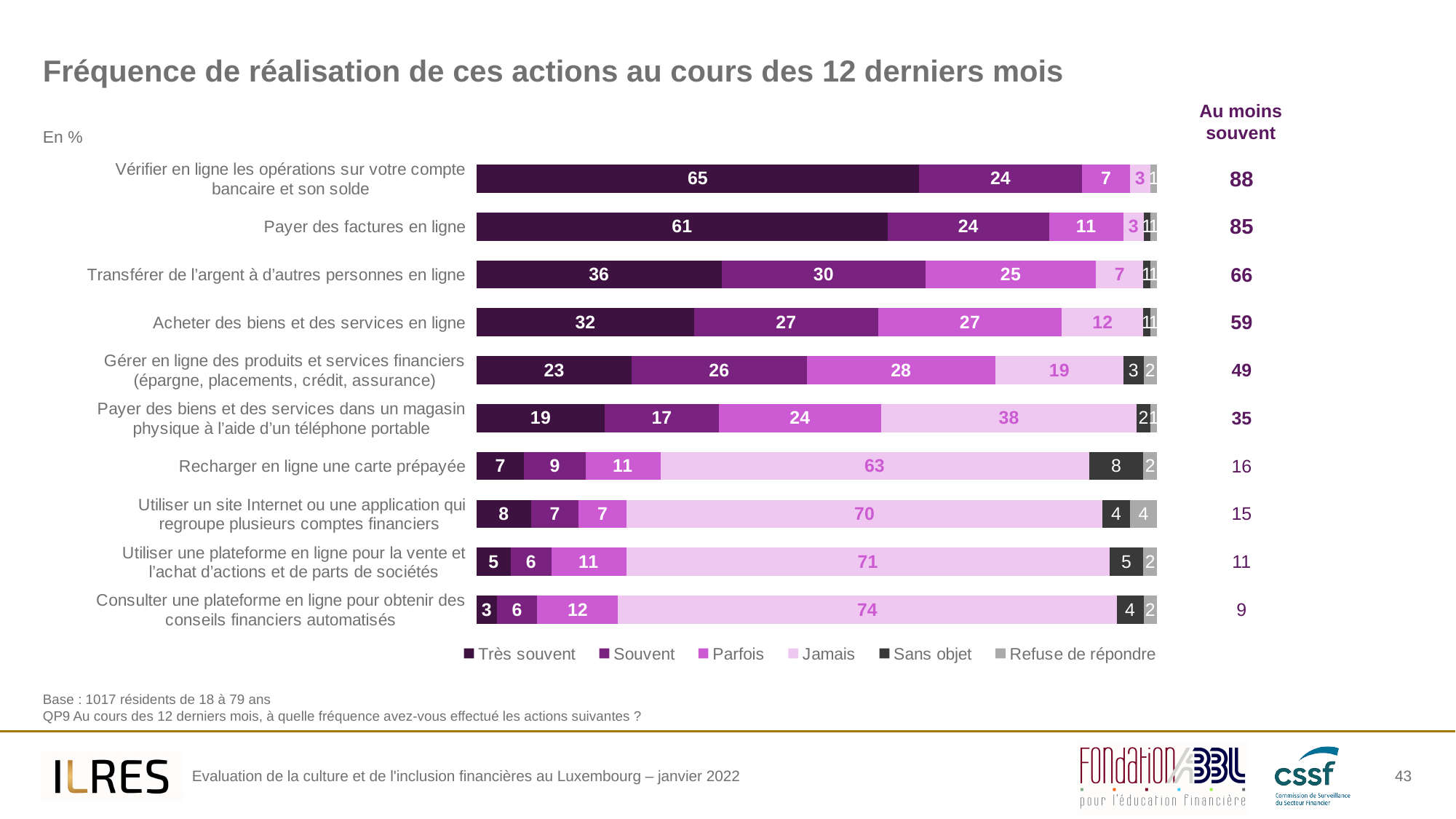
What is the "Parfois" value for "Transférer de l'argent à d'autres personnes en ligne"? 25 What is the "Jamais" value for "Recharger en ligne une carte prépayée"? 63 What kind of chart is shown on the slide? Stacked bar chart Which has a larger "Souvent" value: "Transférer de l'argent à d'autres personnes en ligne" or "Gérer en ligne des produits et services financiers"? Transférer de l'argent à d'autres personnes en ligne What is the "Très souvent" value for "Payer des factures en ligne"? 61 Which category has the lowest "Au moins souvent" value? Consulter une plateforme en ligne pour obtenir des conseils financiers automatisés How many series does the legend list? 6 How many categories (actions) are shown in the chart? 10 What is the title of the chart? Fréquence de réalisation de ces actions au cours des 12 derniers mois What is the difference between the "Jamais" values for "Consulter une plateforme en ligne pour obtenir des conseils financiers automatisés" and "Payer des biens et des services dans un magasin physique à l'aide d'un téléphone portable"? 36 What is the "Au moins souvent" value shown for "Acheter des biens et des services en ligne"? 59 Which category has the highest "Très souvent" value? Vérifier en ligne les opérations sur votre compte bancaire et son solde